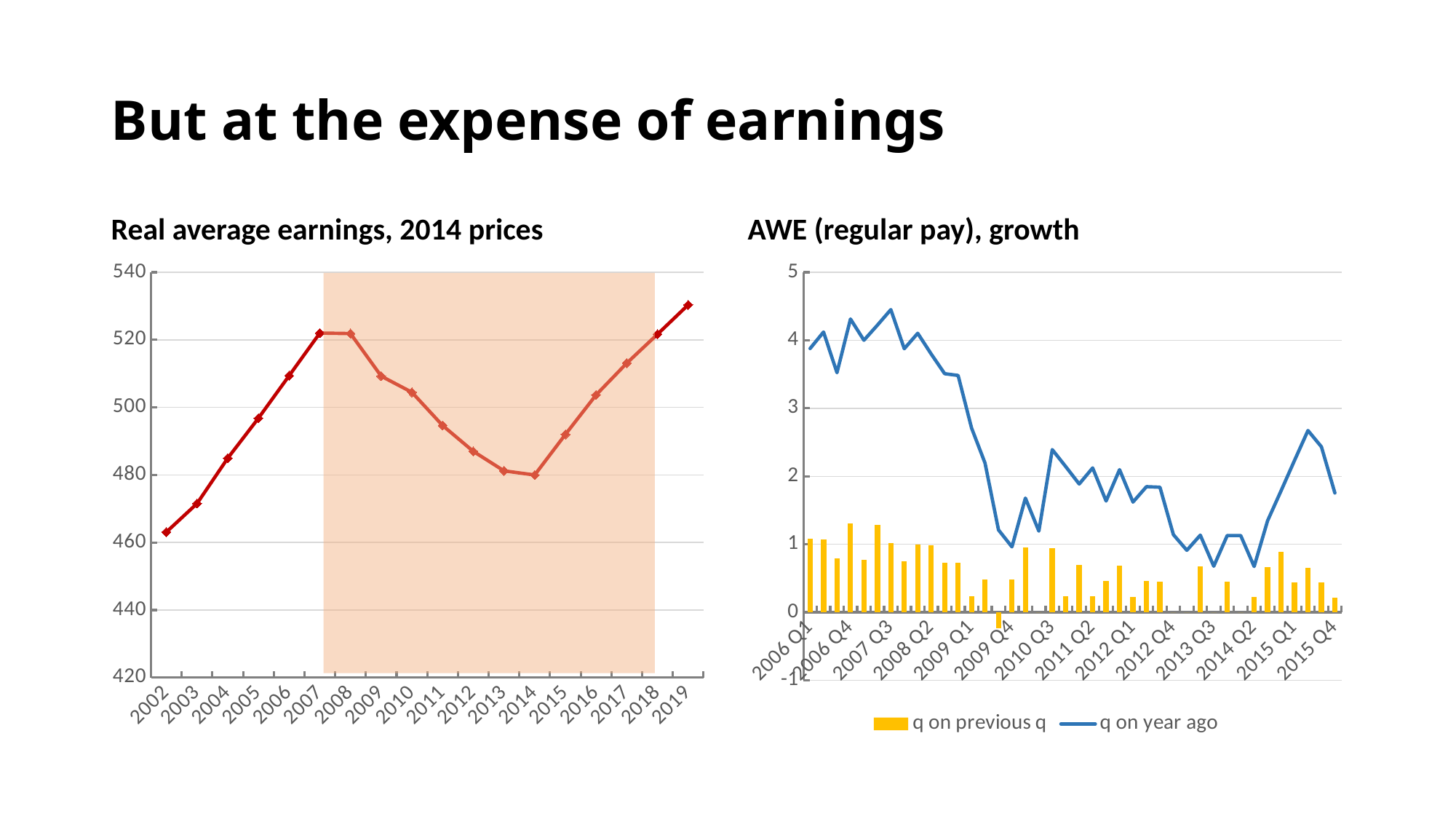
How many years are plotted in the 'Real average earnings, 2014 prices' chart? 18 In the 'AWE (regular pay), growth' chart, is the 'q on year ago' value for 2006 Q1 greater or less than 3? greater In the 'Real average earnings, 2014 prices' chart, is the value for 2002 greater or less than 480? less In the 'AWE (regular pay), growth' chart, which series is shown as a blue line? q on year ago What kind of chart is the 'Real average earnings, 2014 prices' chart? line chart In the 'Real average earnings, 2014 prices' chart, which is larger, the value for 2007 or the value for 2013? 2007 In the 'Real average earnings, 2014 prices' chart, do values rise or fall from 2008 to 2014? fall In the 'Real average earnings, 2014 prices' chart, which year has the lowest value? 2002 In the 'Real average earnings, 2014 prices' chart, which year has the highest value? 2019 In the 'Real average earnings, 2014 prices' chart, is the value for 2007 greater or less than 500? greater How many series does the legend of the 'AWE (regular pay), growth' chart list? 2